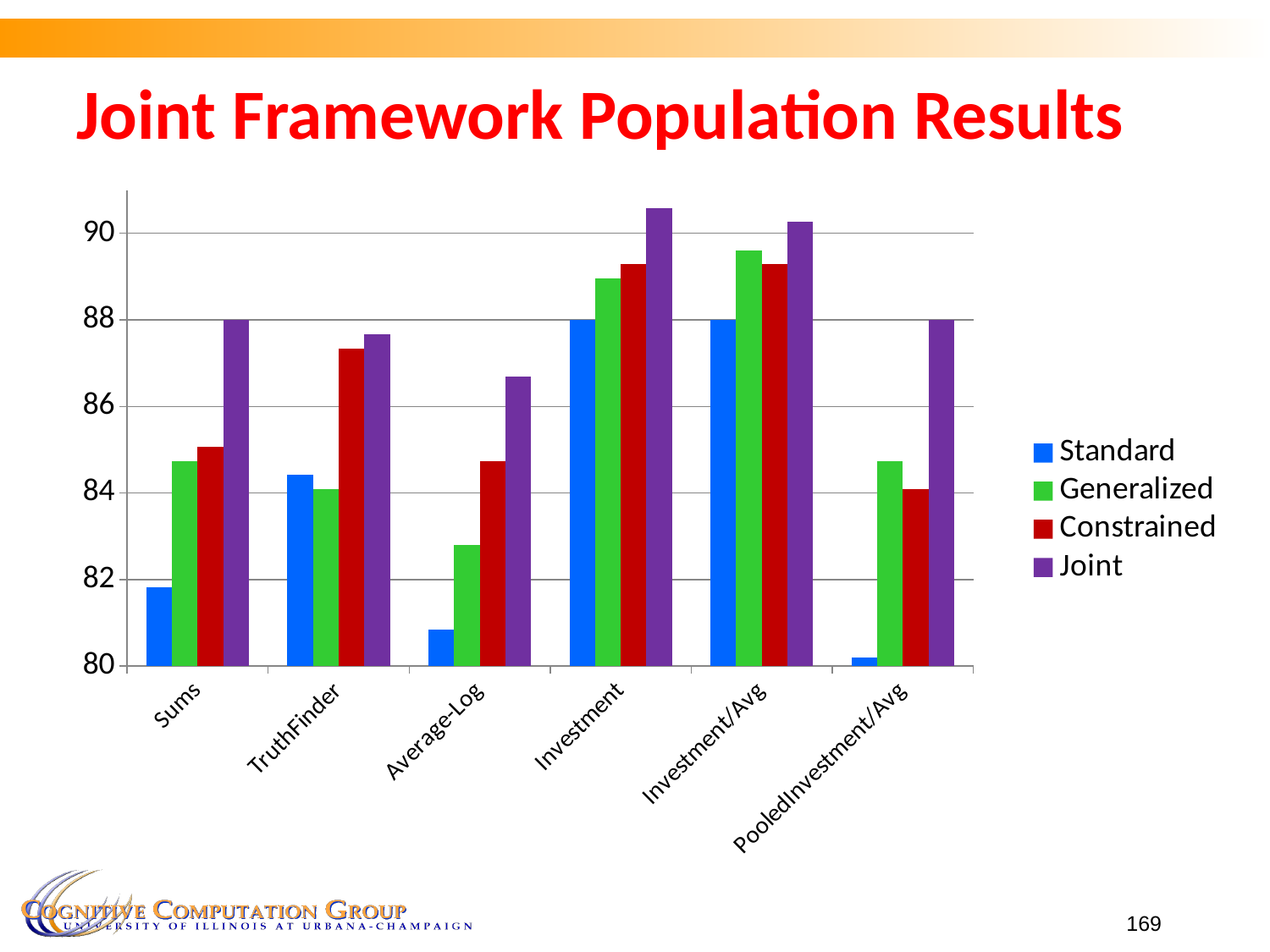
For Sums, which is larger: the Joint value or the Standard value? Joint Which series is shown in purple in the legend? Joint What is the title of the chart? Joint Framework Population Results Is the Joint value for Average-Log greater or less than 86? greater How many series does the legend list? 4 Which series has the highest bar for the Investment category? Joint Is the Standard value for Sums greater or less than 82? less How many categories are shown on the x axis? 6 What kind of chart is shown on the slide? bar chart Which series has the lowest bar for the PooledInvestment/Avg category? Standard Is the Constrained value for TruthFinder greater or less than 86? greater For TruthFinder, which is larger: the Constrained value or the Generalized value? Constrained